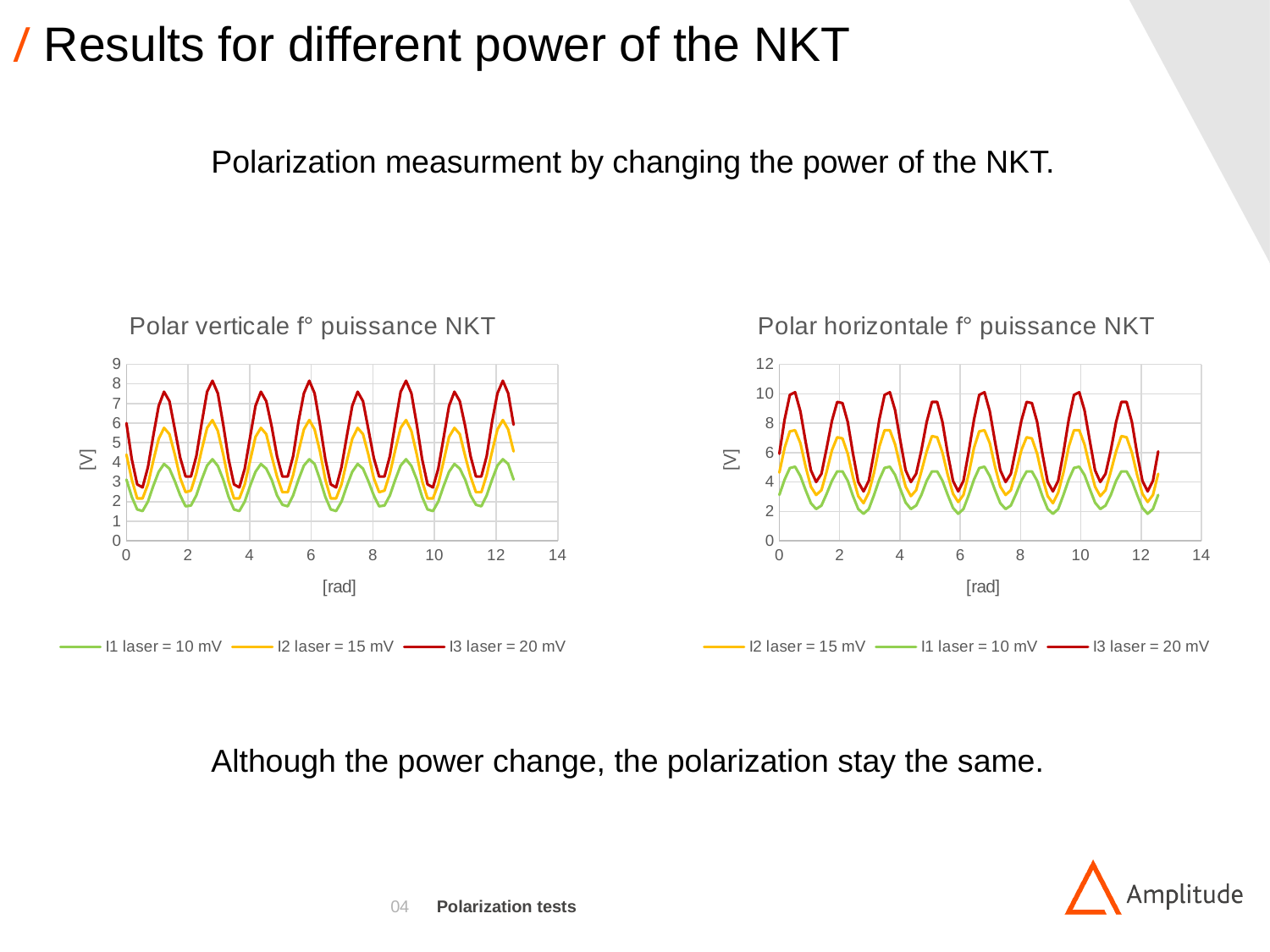
In the 'Polar verticale f° puissance NKT' chart, which series has larger values, I2 laser = 15 mV or I1 laser = 10 mV? I2 laser = 15 mV How many series does the legend of the 'Polar horizontale f° puissance NKT' chart list? 3 What is the title of the chart on the right side of the slide? Polar horizontale f° puissance NKT In the 'Polar verticale f° puissance NKT' chart, are the lowest values of I1 laser = 10 mV greater or less than 2? less In the 'Polar verticale f° puissance NKT' chart, are the peak values of I3 laser = 20 mV greater or less than 7? greater In the 'Polar horizontale f° puissance NKT' chart, which series has the lowest values? I1 laser = 10 mV What is the x-axis label of the 'Polar verticale f° puissance NKT' chart? [rad] In the 'Polar horizontale f° puissance NKT' chart, are the peak values of I3 laser = 20 mV greater or less than 8? greater In the 'Polar verticale f° puissance NKT' chart, which series reaches the highest values? I3 laser = 20 mV What kind of chart is the 'Polar verticale f° puissance NKT' chart? line chart Do the values in the 'Polar horizontale f° puissance NKT' chart show a steady rise, a steady fall, or a repeating oscillation along the x axis? repeating oscillation